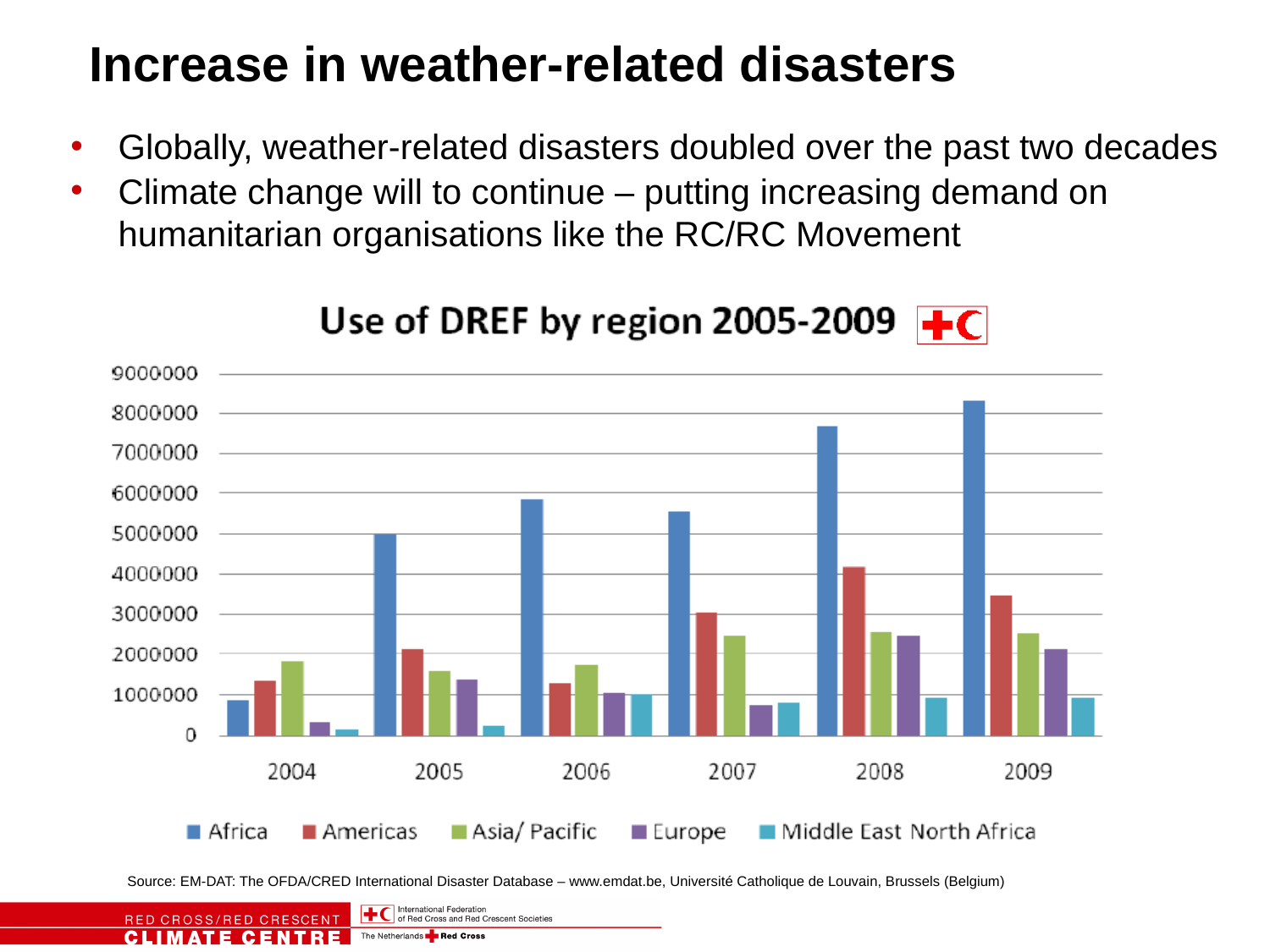
Is the value for Africa in 2009 greater or less than 8000000? greater Is the value for Americas in 2008 greater or less than 4000000? greater In which year is the Africa bar the lowest? 2004 In which year is the Africa bar the highest? 2009 How many series does the chart legend list? 5 In 2008, which is larger: the Americas bar or the Asia/ Pacific bar? Americas What is the title of the chart? Use of DREF by region 2005-2009 Which region has the tallest bar in 2009? Africa Which region has the lowest bar in 2004? Middle East North Africa What kind of chart is shown on the slide? Bar chart How many years are shown along the x axis of the chart? 6 Is the value for Africa in 2004 greater or less than 1000000? less